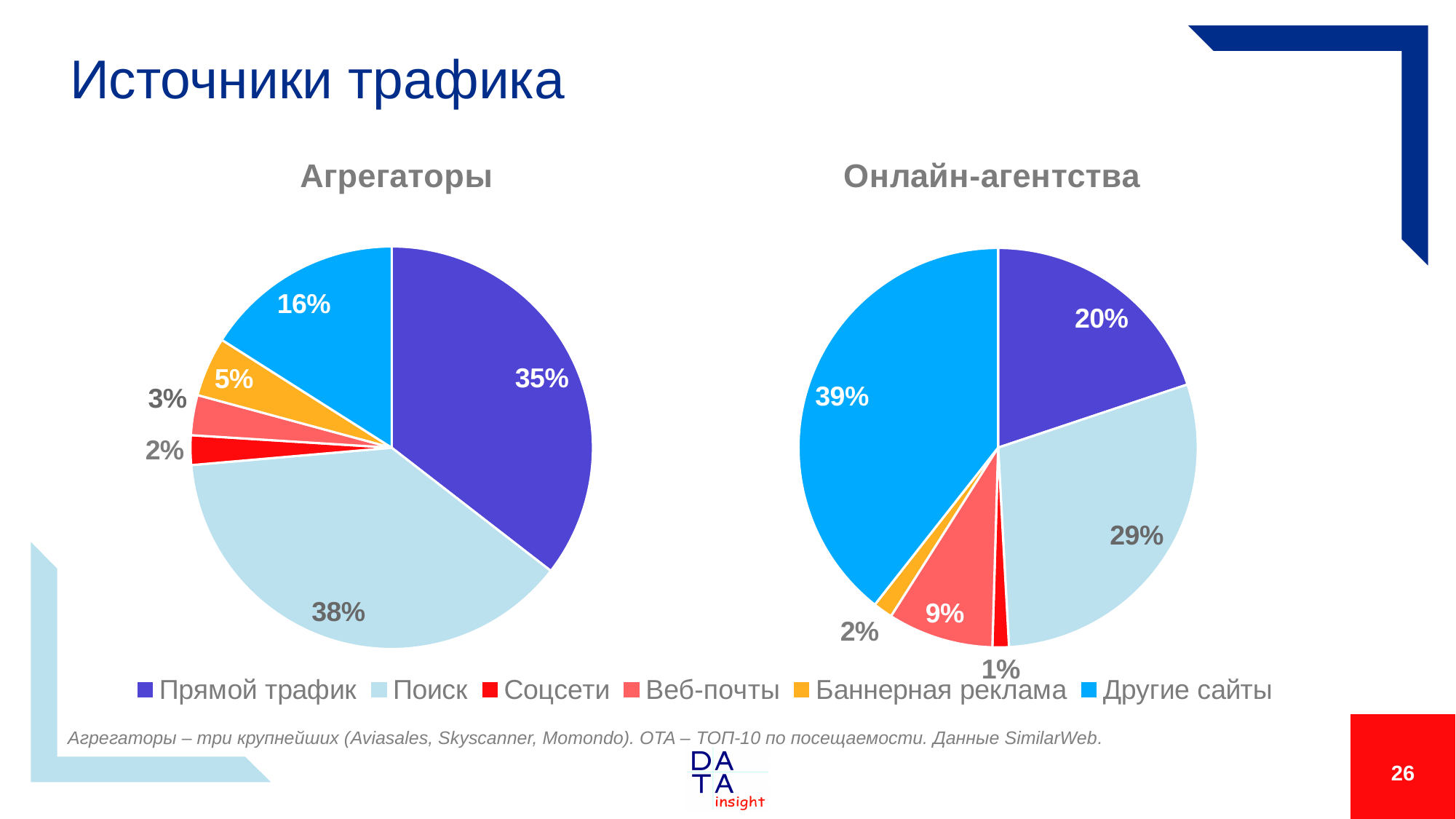
In the "Онлайн-агентства" chart, which category has the smallest share? Соцсети In the "Агрегаторы" chart, what is the value for "Баннерная реклама"? 5% What type of chart is used on this slide? Pie chart What is the title of the chart on the right? Онлайн-агентства In the "Онлайн-агентства" chart, what is the difference between the shares of "Другие сайты" and "Поиск"? 10% In the "Онлайн-агентства" chart, what share does "Другие сайты" have? 39% How many categories does the legend list? 6 In the "Онлайн-агентства" chart, what is the value for "Веб-почты"? 9% In the "Агрегаторы" chart, what share does "Поиск" have? 38% In the "Агрегаторы" chart, what is the difference between the shares of "Поиск" and "Прямой трафик"? 3% In the "Агрегаторы" chart, which category has the largest share? Поиск Which chart shows a larger share for "Прямой трафик", "Агрегаторы" or "Онлайн-агентства"? Агрегаторы